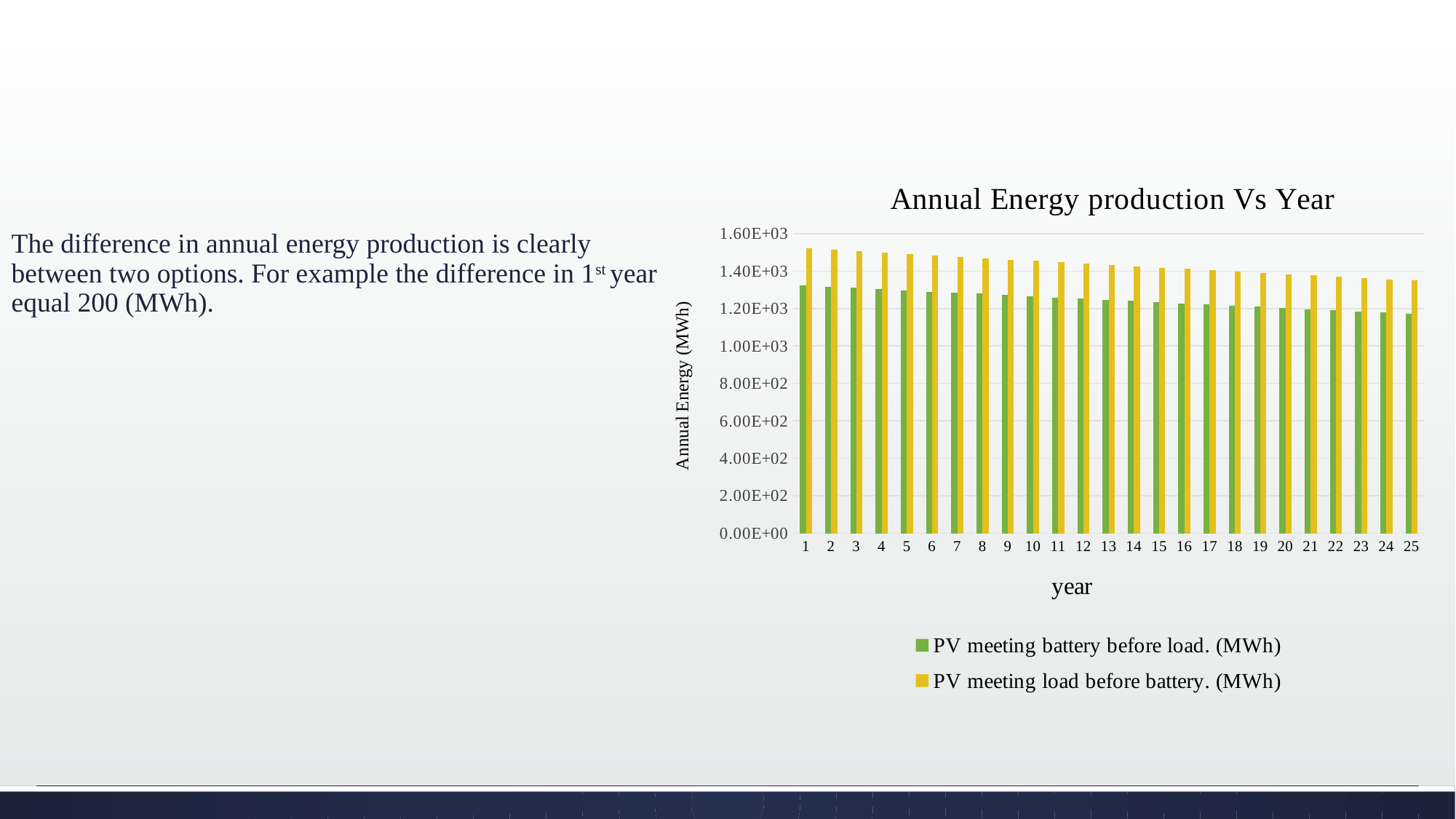
Do the values for the PV meeting load before battery series rise or fall as the year increases? fall Do the values for the PV meeting battery before load series rise or fall as the year increases? fall What kind of chart is shown on the slide? bar chart How many years are plotted along the x axis? 25 Which year has the lowest value for PV meeting battery before load? 25 Which series is shown in yellow? PV meeting load before battery. (MWh) Which year has the highest value for PV meeting load before battery? 1 Is the value for PV meeting battery before load in year 25 greater or less than 1.20E+03? less How many series does the legend list? 2 In year 1, which series has the larger value: PV meeting battery before load or PV meeting load before battery? PV meeting load before battery What is the title of the chart? Annual Energy production Vs Year Is the value for PV meeting load before battery in year 1 greater or less than 1.40E+03? greater